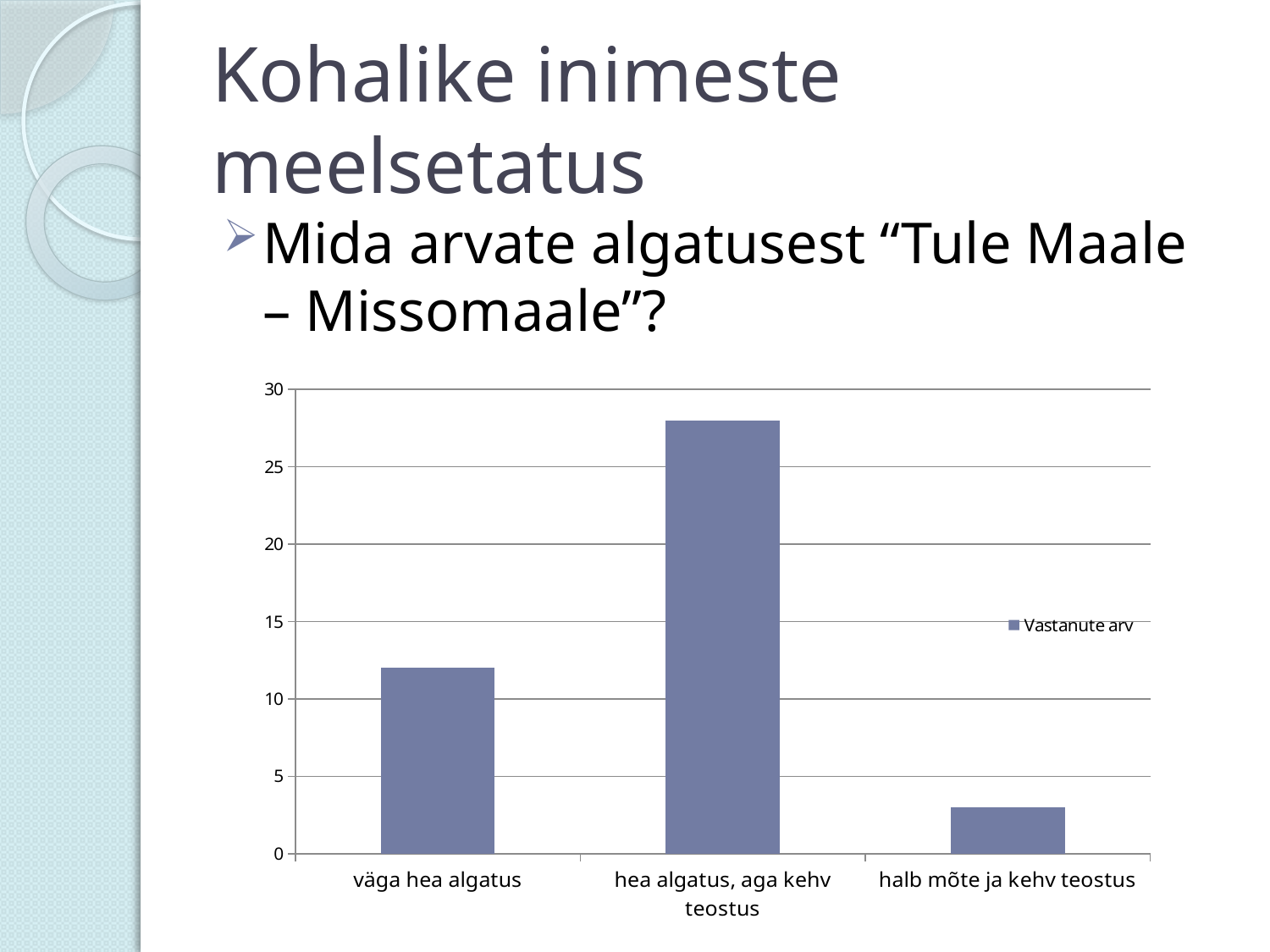
Is the value for "halb mõte ja kehv teostus" greater or less than 5? less How many categories are shown on the x axis of the chart? 3 Which category has the lowest value in the chart? halb mõte ja kehv teostus What is the highest value shown on the chart's vertical axis? 30 Is the value for "hea algatus, aga kehv teostus" greater or less than 25? greater How many series does the chart legend list? 1 Which is larger: the value for "väga hea algatus" or the value for "halb mõte ja kehv teostus"? väga hea algatus Is the value for "väga hea algatus" greater or less than 10? greater Which category has the highest value in the chart? hea algatus, aga kehv teostus What is the name of the series shown in the chart legend? Vastanute arv What kind of chart is shown on the slide? bar chart